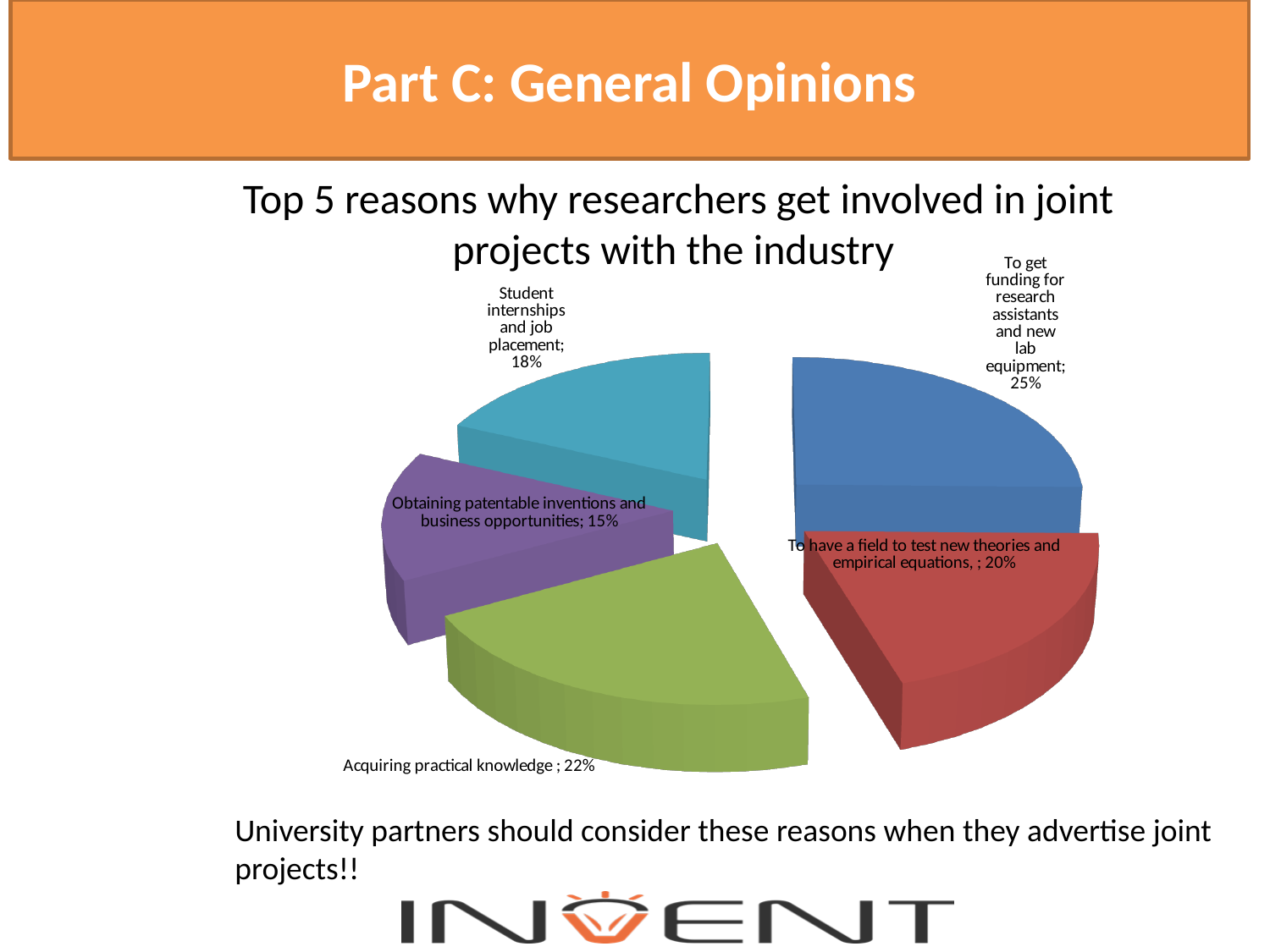
What percentage is shown for 'To have a field to test new theories and empirical equations'? 20% What percentage is shown for 'Acquiring practical knowledge'? 22% How many slices does the pie chart have? 5 Which reason has the largest share of the pie? To get funding for research assistants and new lab equipment What percentage is shown for 'Student internships and job placement'? 18% What percentage is shown for 'To get funding for research assistants and new lab equipment'? 25% Which is larger: the share for 'Acquiring practical knowledge' or the share for 'Student internships and job placement'? Acquiring practical knowledge What is the title of the chart? Top 5 reasons why researchers get involved in joint projects with the industry What kind of chart is shown on the slide? pie chart What percentage is shown for 'Obtaining patentable inventions and business opportunities'? 15% What is the difference in percentage points between 'To get funding for research assistants and new lab equipment' and 'Obtaining patentable inventions and business opportunities'? 10 Which reason has the smallest share of the pie? Obtaining patentable inventions and business opportunities